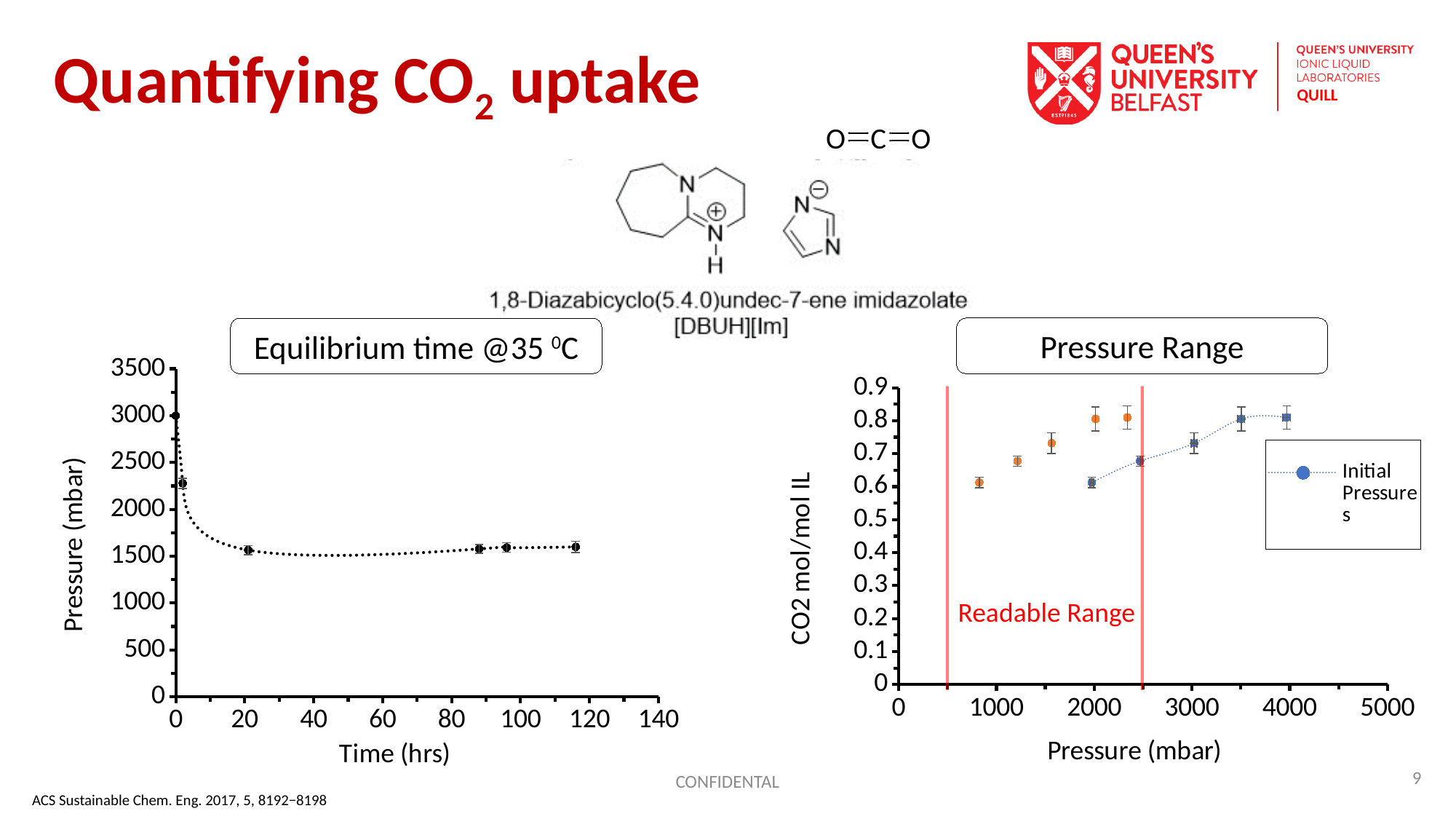
In the 'Equilibrium time @35 °C' chart, what is the label of the y axis? Pressure (mbar) In the 'Equilibrium time @35 °C' chart, does the pressure rise or fall over the first 20 hours? Fall In the 'Equilibrium time @35 °C' chart, is the pressure at time 0 greater or less than 2500 mbar? greater How many data points are plotted in the 'Equilibrium time @35 °C' chart? 6 What kind of chart is the 'Equilibrium time @35 °C' chart on the left? Scatter chart with a dotted line In the 'Pressure Range' chart, is the CO2 mol/mol IL value for the blue point at about 4000 mbar greater or less than 0.7? greater How many series does the legend of the 'Pressure Range' chart list? 1 In the 'Pressure Range' chart, is the CO2 mol/mol IL value for the orange point at about 800 mbar greater or less than 0.7? less In the 'Pressure Range' chart, does CO2 uptake rise or fall as pressure increases along the x axis? Rise In the 'Pressure Range' chart, what is the label of the y axis? CO2 mol/mol IL In the 'Equilibrium time @35 °C' chart, what is the label of the x axis? Time (hrs)